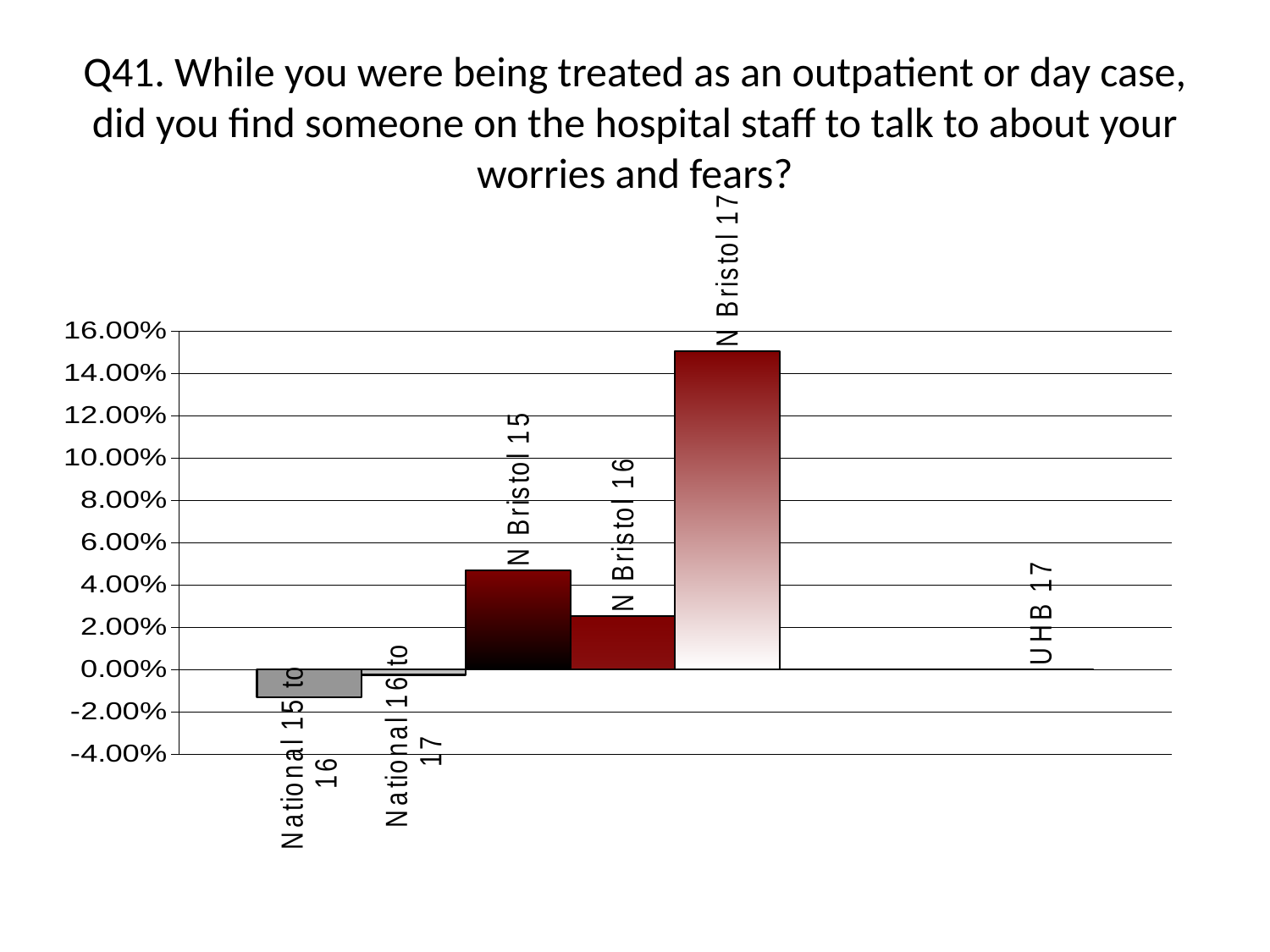
Is the value for N Bristol 17 greater or less than 14.00%? greater Is the value for N Bristol 16 greater or less than 4.00%? less What question number is referenced in the chart title? Q41 How many categories are shown on the x axis of the chart? 6 Which category has the lowest value in the chart? National 15 to 16 Which category has the highest value in the chart? N Bristol 17 Which is larger, the value for National 15 to 16 or the value for National 16 to 17? National 16 to 17 Is the value for N Bristol 15 greater or less than 4.00%? greater Which is larger, the value for N Bristol 15 or the value for N Bristol 16? N Bristol 15 What kind of chart is shown on the slide? bar chart How many categories in the chart have a value below 0.00%? 2